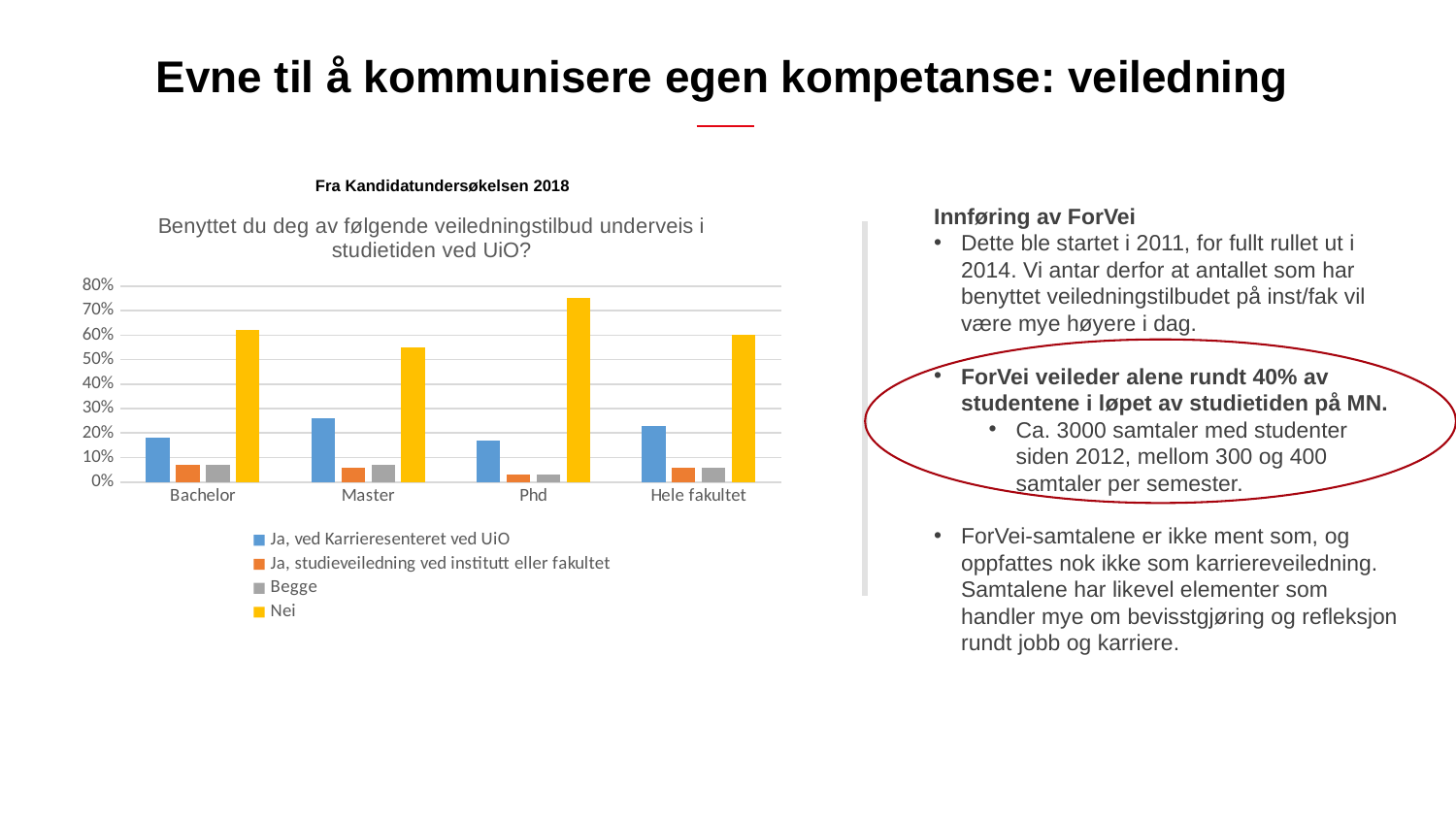
How many series does the chart's legend list? 4 Which series has the highest value in the Bachelor category? Nei Which is larger for 'Ja, ved Karrieresenteret ved UiO': Bachelor or Master? Master Is the 'Nei' value for Phd greater or less than 70%? greater Which category has the lowest value for the 'Nei' series? Master Is the 'Nei' value for Bachelor greater or less than 50%? greater How many categories are shown along the x axis of the chart? 4 Which legend entry is shown in yellow? Nei What kind of chart is shown on the slide? Bar chart Is the 'Ja, ved Karrieresenteret ved UiO' value for Master greater or less than 20%? greater Which category has the highest value for the 'Nei' series? Phd